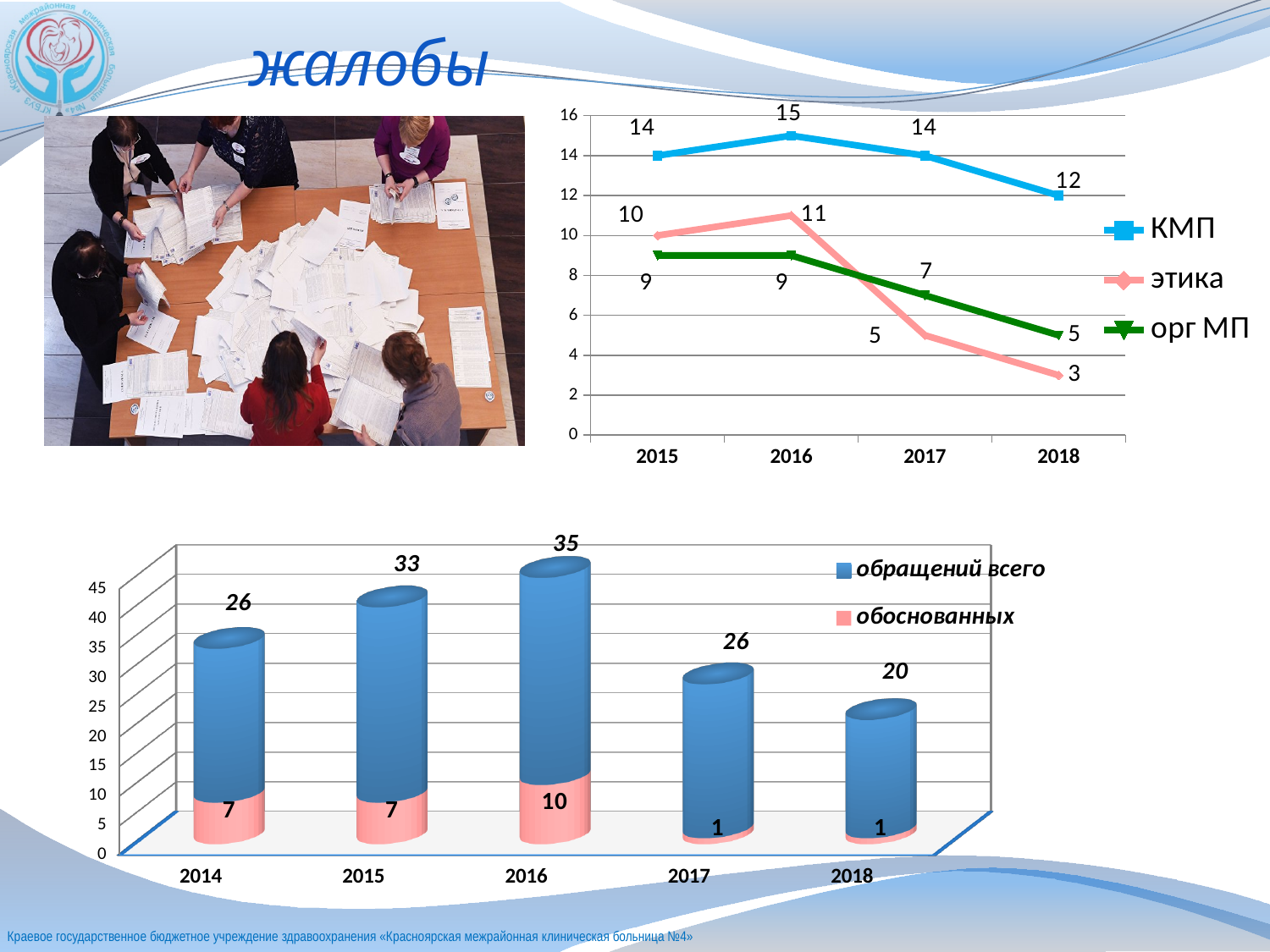
In the bottom bar chart, how many years are shown on the x axis? 5 In the top-right line chart, what is the value for этика in 2018? 3 In the top-right line chart, what is the difference between КМП and этика in 2017? 9 In the bottom bar chart, what is the value for обоснованных in 2017? 1 What kind of chart is the bottom chart? bar chart In the top-right line chart, how many series does the legend list? 3 In the top-right line chart, does the этика series rise or fall from 2016 to 2018? fall In the top-right line chart, what is the value for КМП in 2016? 15 In the top-right line chart, which series has the highest value in 2018? КМП In the bottom bar chart, which year has the lowest value for обращений всего? 2018 In the top-right line chart, what is the value for орг МП in 2017? 7 In the bottom bar chart, what is the value for обращений всего in 2016? 35